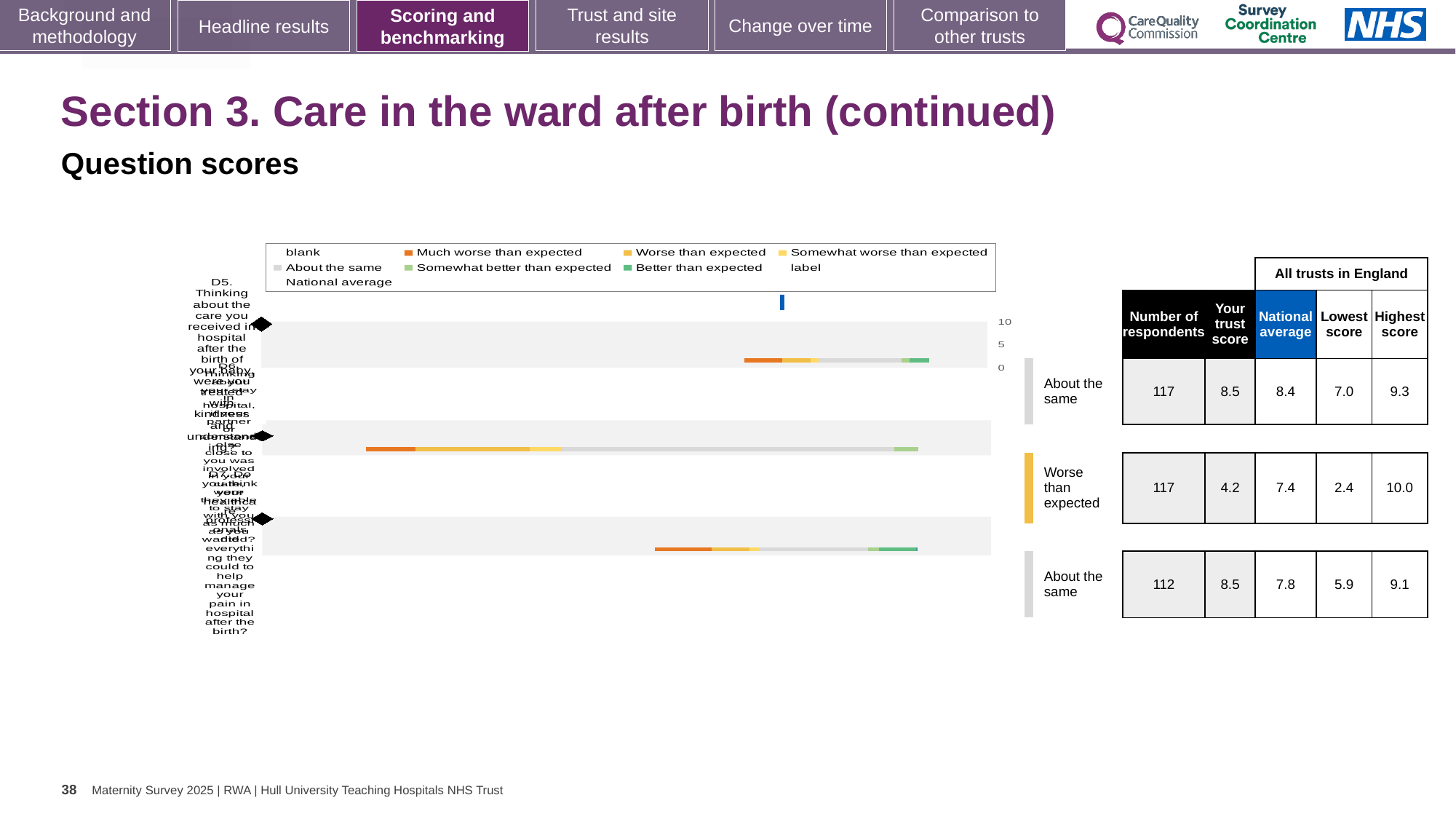
In the table beside the chart, which row has the lowest 'Your trust score'? the middle row (Worse than expected) How many horizontal bars are plotted in the chart? 3 In the table beside the chart, what is the number of respondents for the bottom row? 112 Which legend entry is shown in orange in the chart? Much worse than expected In the table beside the chart, what is the highest score for the middle row (labelled 'Worse than expected')? 10.0 In the table beside the chart, which is larger for the middle row: the trust score or the national average? national average What benchmark label is shown next to the middle bar of the chart? Worse than expected In the table beside the chart, what is the 'Your trust score' for the middle row (labelled 'Worse than expected')? 4.2 What is the highest tick value shown on the chart's axis? 10 In the table beside the chart, what is the national average for the top row? 8.4 In the table beside the chart, what is the difference between the highest score and the lowest score for the top row? 2.3 What kind of chart is shown on the slide? bar chart